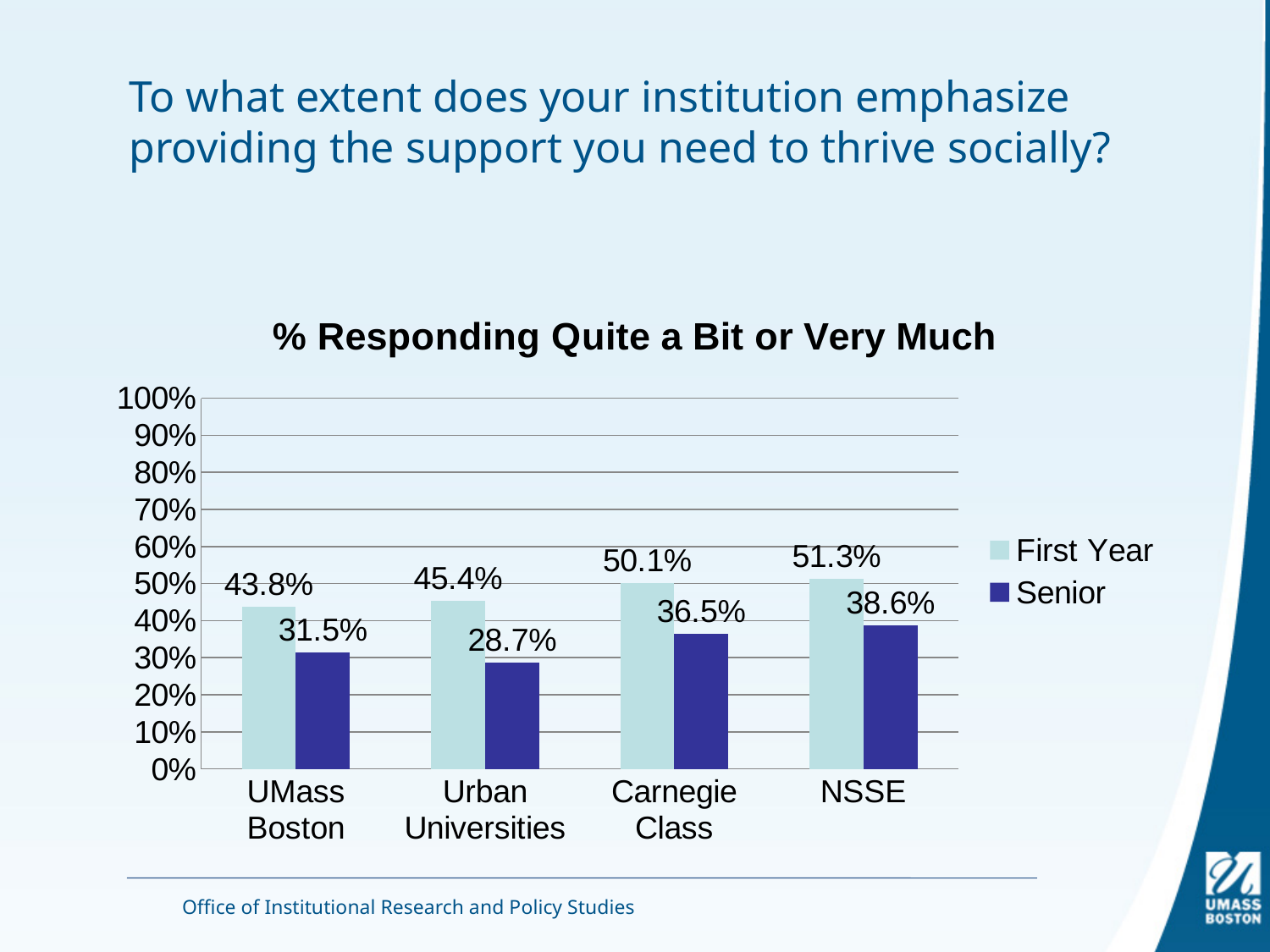
What is the Senior value for Urban Universities? 28.7% What is the difference between the First Year and Senior values for Carnegie Class? 13.6% What kind of chart is shown? bar chart Which category has the highest First Year value? NSSE What is the title of the chart? % Responding Quite a Bit or Very Much Which category has the lowest Senior value? Urban Universities How many categories are shown on the x axis? 4 Which is larger, the Senior value for UMass Boston or the Senior value for Carnegie Class? Carnegie Class Is the First Year value for Urban Universities greater or less than 50%? less What is the First Year value for UMass Boston? 43.8% How many series does the legend list? 2 What is the Senior value for NSSE? 38.6%